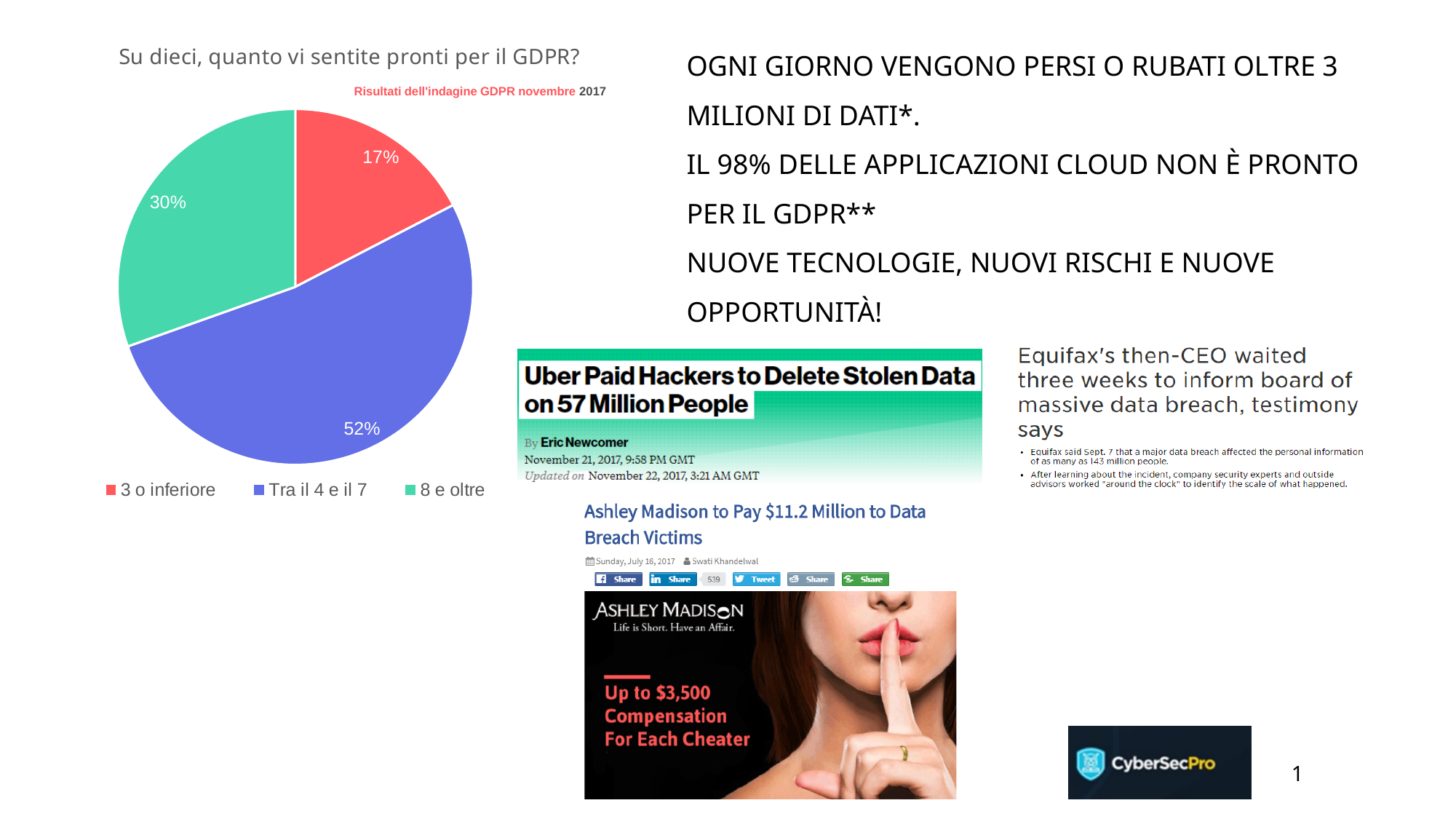
Which category has the largest slice of the pie? Tra il 4 e il 7 What is the difference in percentage points between the "Tra il 4 e il 7" slice and the "8 e oltre" slice? 22 What share of the pie does the "Tra il 4 e il 7" slice represent? 52% Which is larger, the "8 e oltre" slice or the "3 o inferiore" slice? 8 e oltre What share of the pie does the "8 e oltre" slice represent? 30% What kind of chart is shown on the slide? pie chart What share of the pie does the "3 o inferiore" slice represent? 17% What is the difference in percentage points between the "8 e oltre" slice and the "3 o inferiore" slice? 13 What colour is the "3 o inferiore" slice in the pie chart? red How many categories does the pie chart show? 3 What is the title of the pie chart? Su dieci, quanto vi sentite pronti per il GDPR? Which category has the smallest slice of the pie? 3 o inferiore